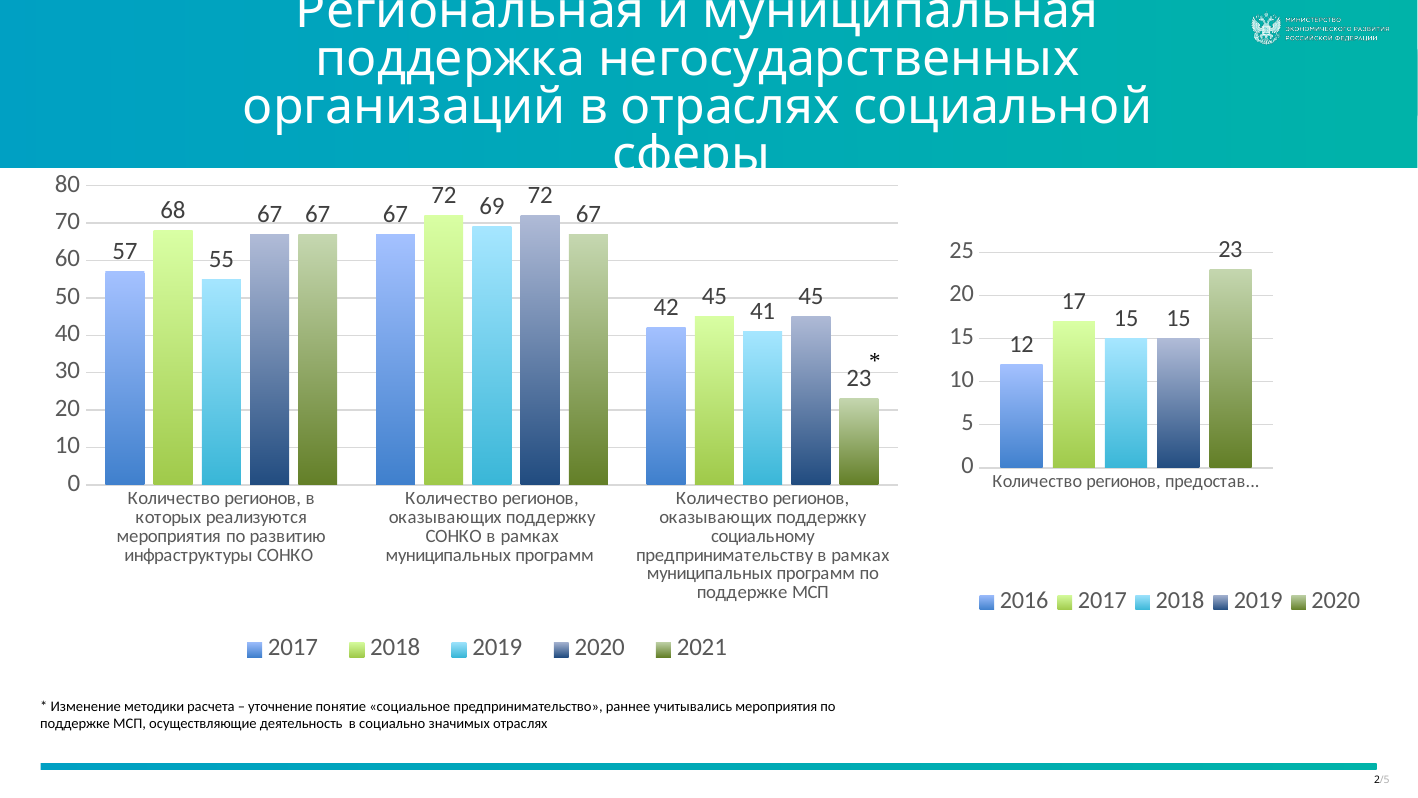
On the left chart, which is larger for 'Количество регионов, оказывающих поддержку социальному предпринимательству в рамках муниципальных программ по поддержке МСП': the 2018 value or the 2019 value? 2018 On the left chart, which year has the lowest value for 'Количество регионов, в которых реализуются мероприятия по развитию инфраструктуры СОНКО'? 2019 On the left chart, what is the 2021 value for 'Количество регионов, оказывающих поддержку социальному предпринимательству в рамках муниципальных программ по поддержке МСП'? 23 How many categories are shown on the x axis of the left chart? 3 How many series does the legend of the left chart list? 5 On the left chart, what is the 2017 value for 'Количество регионов, в которых реализуются мероприятия по развитию инфраструктуры СОНКО'? 57 On the right chart, what is the value for 2020? 23 On the left chart, what is the difference between the 2018 and 2017 values for 'Количество регионов, в которых реализуются мероприятия по развитию инфраструктуры СОНКО'? 11 What kind of chart is the right chart? bar chart On the right chart, which year has the lowest value? 2016 On the left chart, what is the 2019 value for 'Количество регионов, оказывающих поддержку СОНКО в рамках муниципальных программ'? 69 On the right chart, what is the difference between the 2020 and 2016 values? 11